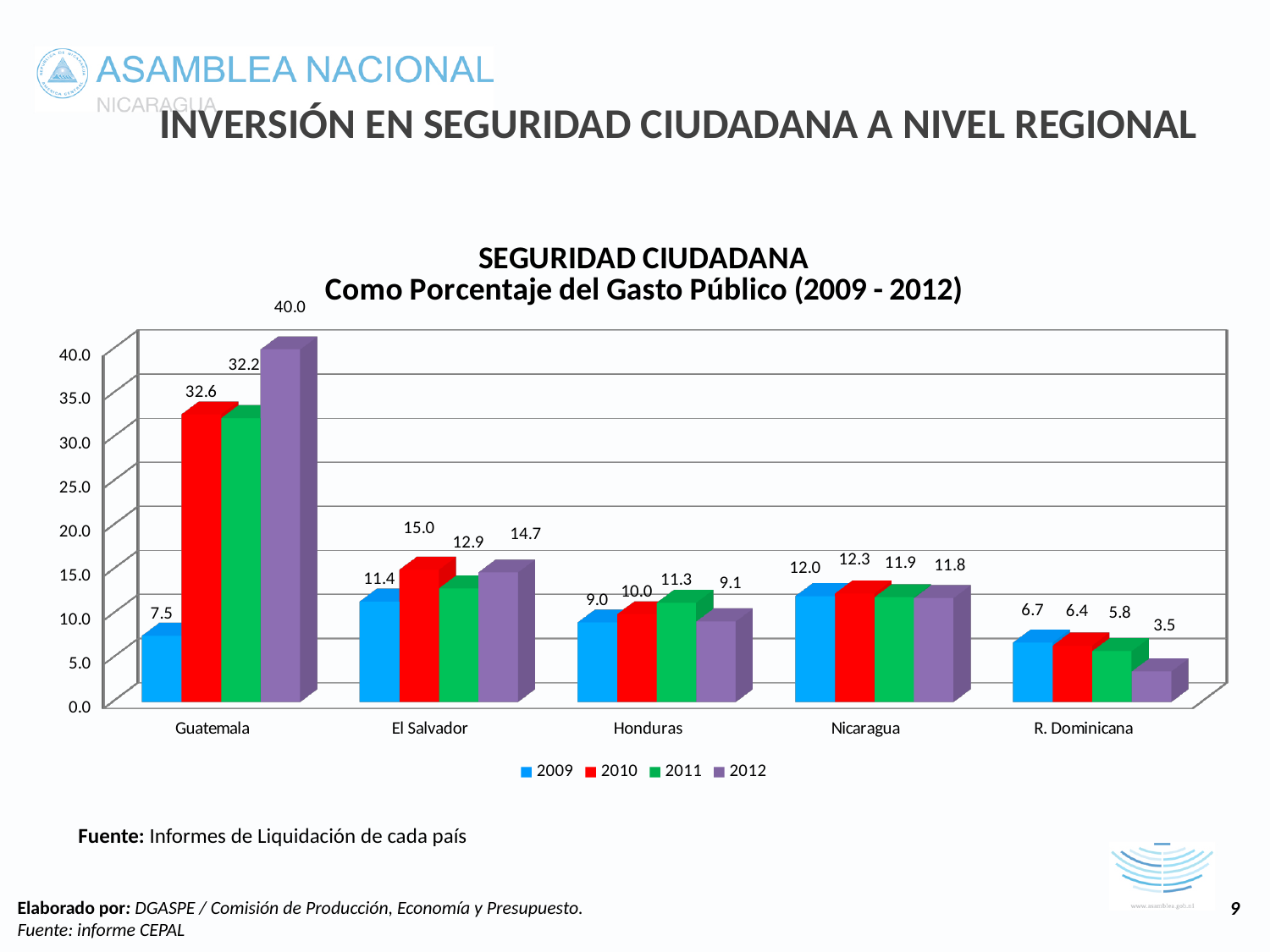
Which country has the lowest value in 2009? R. Dominicana What is the value for Honduras in 2011? 11.3 What kind of chart is this? Bar chart Which country has the highest value in 2010? Guatemala Do the values for R. Dominicana rise or fall from 2009 to 2012? Fall Which is larger: El Salvador in 2010 or Nicaragua in 2010? El Salvador in 2010 What is the value for Guatemala in 2012? 40.0 How many series does the legend list? 4 What is the difference between Guatemala's 2012 value and its 2009 value? 32.5 How many countries are shown on the x axis? 5 What is the value for R. Dominicana in 2012? 3.5 Which colour represents the 2011 series in the legend? Green